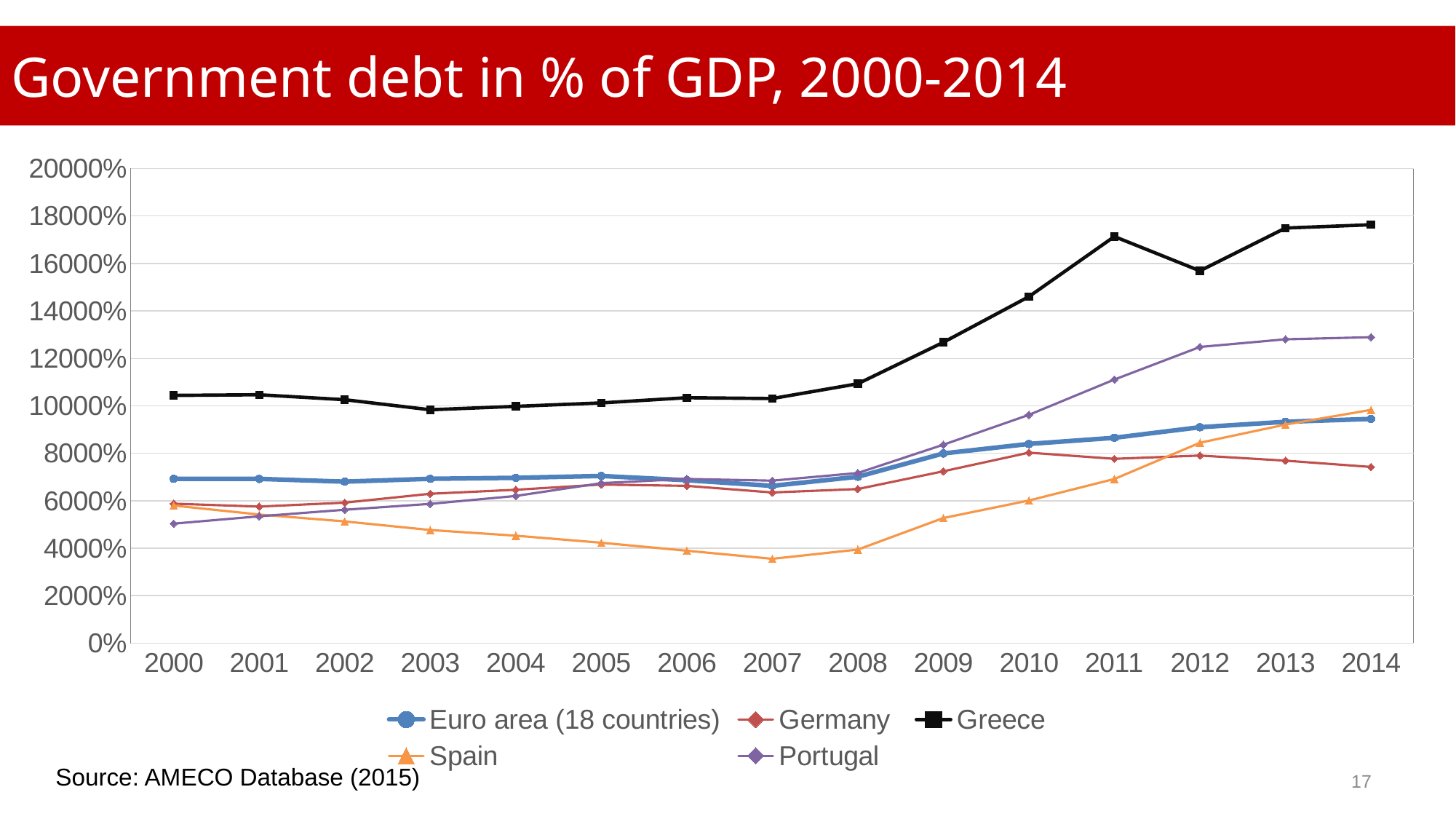
Which series has the lowest value in 2007? Spain How many years are plotted along the x axis? 15 Does the value for Greece rise or fall from 2008 to 2011? rise Which series has the lowest value in 2000? Portugal Is the value for Greece in 2011 greater or less than 16000%? greater What kind of chart is shown on the slide? line chart In 2014, which is larger: the value for Portugal or the value for Germany? Portugal Which series has the highest value in 2014? Greece Is the value for Spain in 2007 greater or less than 4000%? less How many series does the legend list? 5 What is the title of the chart? Government debt in % of GDP, 2000-2014 Is the value for Portugal in 2012 greater or less than 12000%? greater